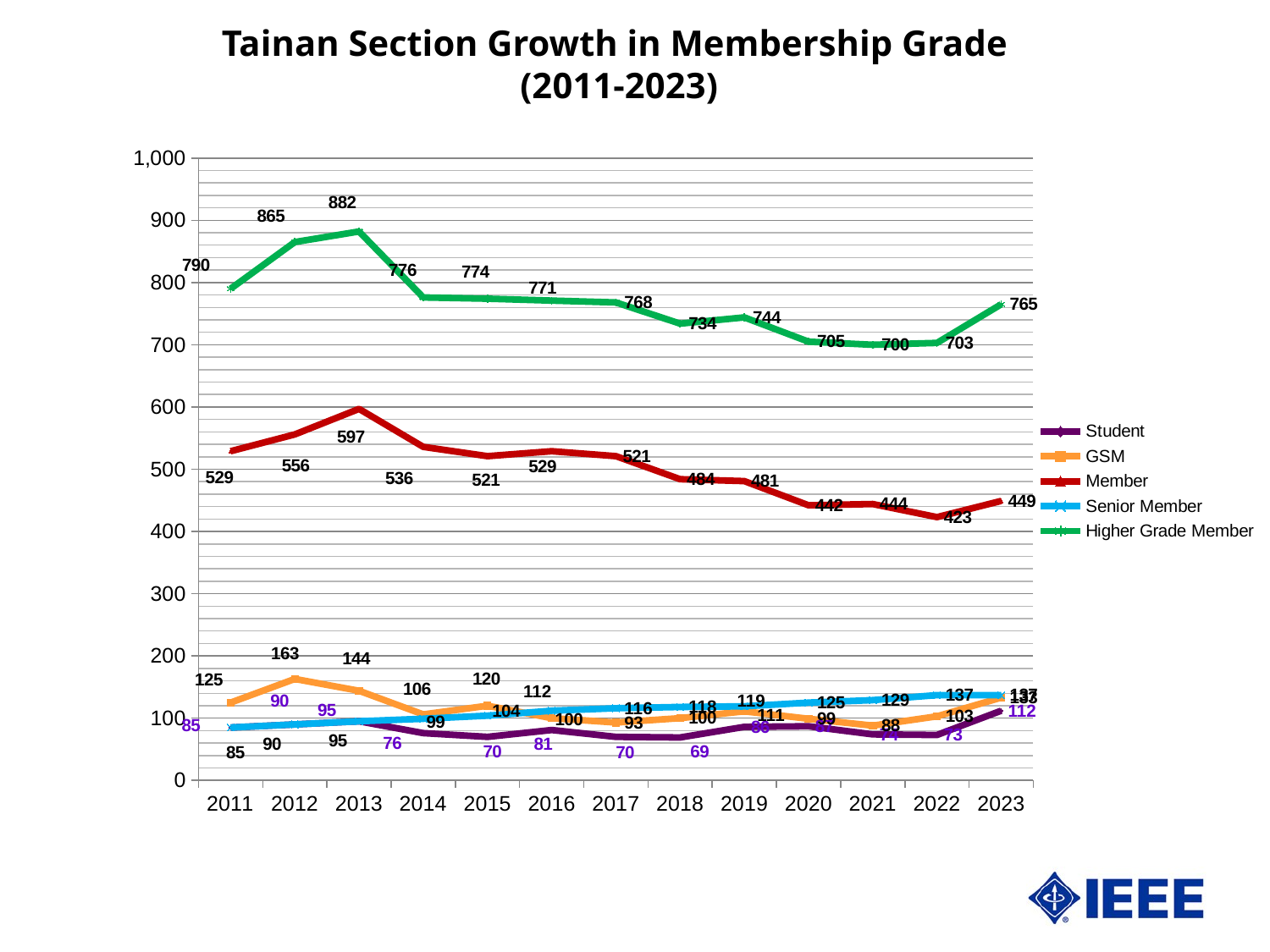
In which year is the Higher Grade Member series at its lowest? 2021 What is the value for Member in 2022? 423 What kind of chart is shown on the slide? line chart How many series does the legend list? 5 Is the value for Member in 2013 greater or less than 500? greater How many years are plotted on the x axis? 13 Which is larger, the Member value in 2011 or in 2023? 2011 What is the value for Higher Grade Member in 2013? 882 In which year is the Member series at its lowest? 2022 What is the difference between the Higher Grade Member values in 2013 and 2011? 92 What is the value for Higher Grade Member in 2023? 765 In which year is the Higher Grade Member series at its highest? 2013